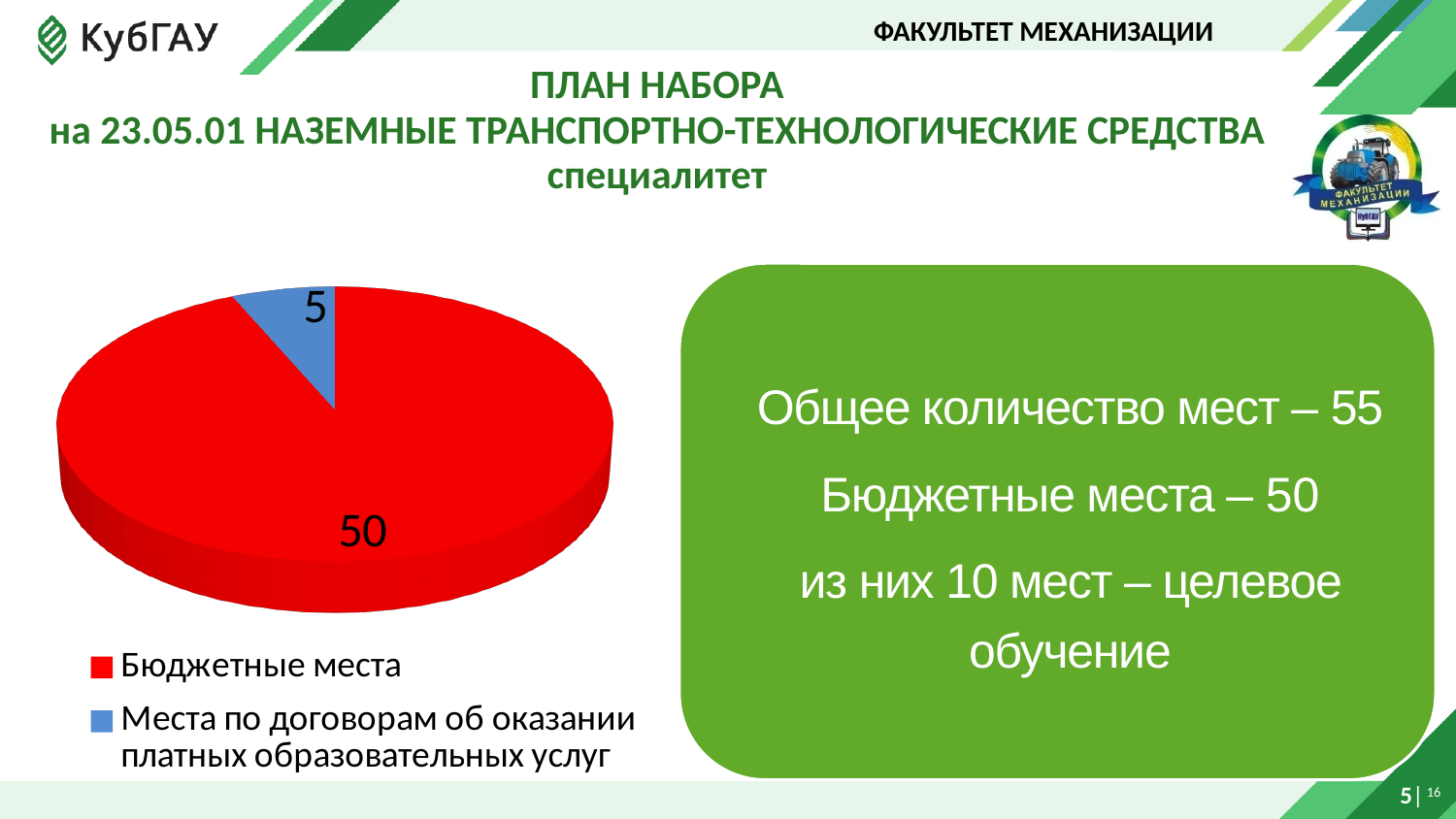
Which is larger: Бюджетные места or Места по договорам об оказании платных образовательных услуг? Бюджетные места Which category has the largest slice? Бюджетные места What colour is the slice for Бюджетные места? red Which category has the smallest slice? Места по договорам об оказании платных образовательных услуг What is the difference between the value for Бюджетные места and the value for Места по договорам об оказании платных образовательных услуг? 45 How many entries does the legend list? 2 What kind of chart is shown on the slide? pie chart What is the total of all slices in the pie chart? 55 What is the value for Бюджетные места? 50 How many slices does the pie chart have? 2 What is the value for Места по договорам об оказании платных образовательных услуг? 5